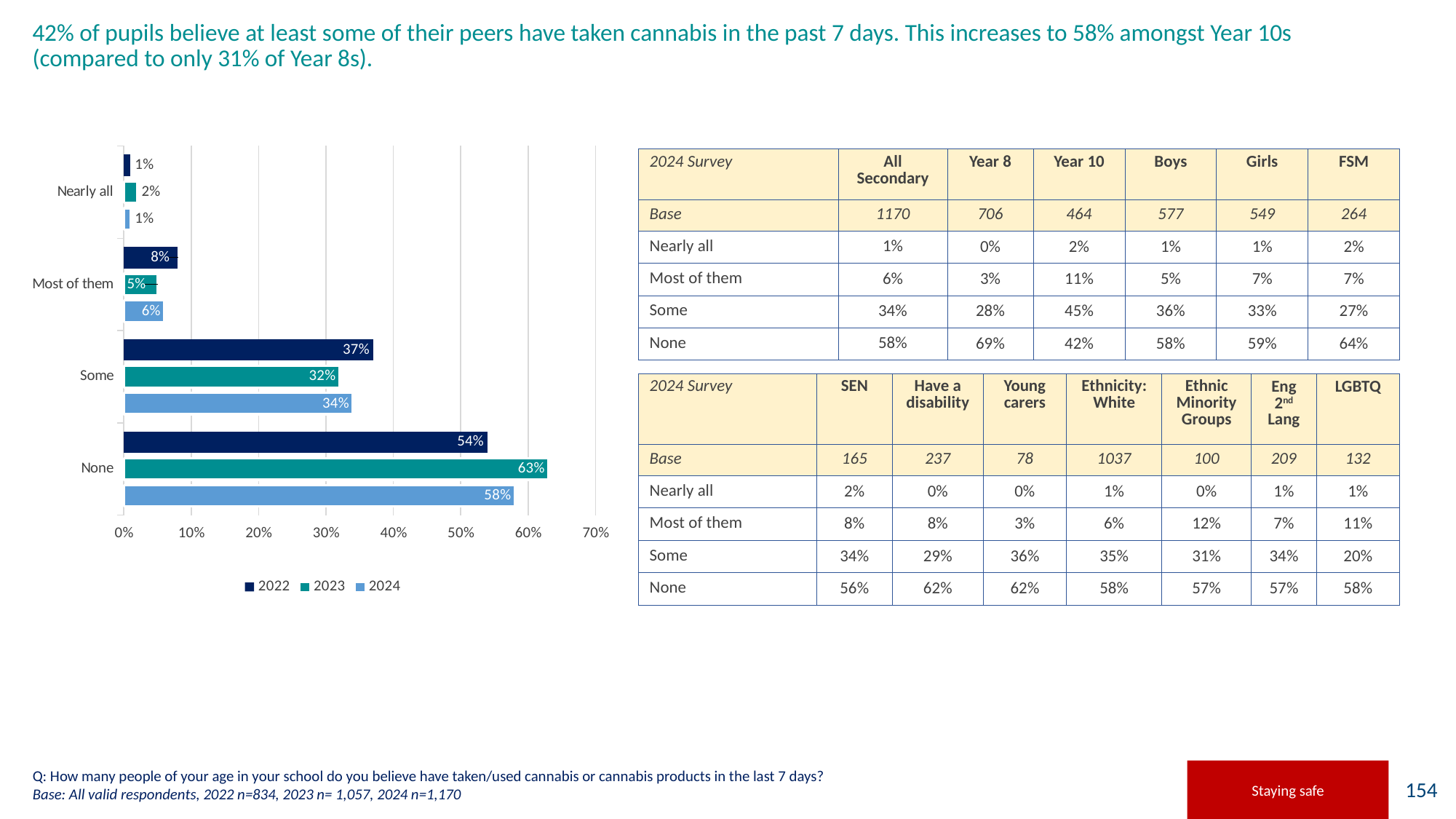
What is the 2023 value for 'Some' in the chart? 32% What is the 2024 value for 'None' in the chart? 58% What is the 2022 value for 'Most of them' in the chart? 8% Is the 2024 value for 'None' in the chart greater or less than 50%? greater Which category has the lowest 2022 value in the chart? Nearly all What kind of chart is shown on the slide? Bar chart In the chart, is the 2022 value for 'Some' larger or the 2024 value for 'Some'? 2022 Which series in the chart legend is shown in dark navy blue? 2022 Which category has the highest 2023 value in the chart? None How many series does the chart legend list? 3 How many categories are shown on the chart's vertical axis? 4 What is the difference between the 2023 and 2022 values for 'None' in the chart? 9%